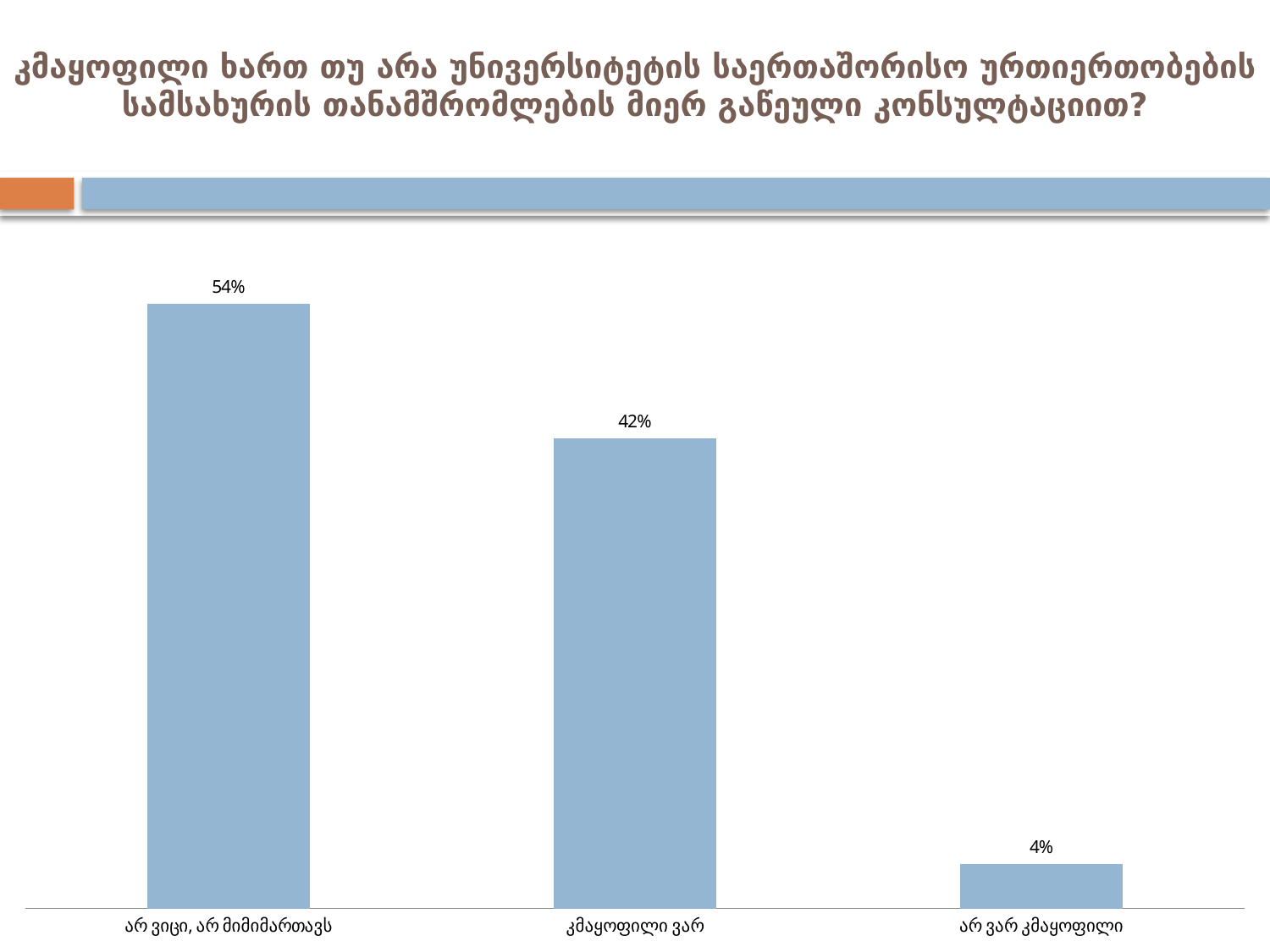
What kind of chart is shown on the slide? Bar chart What is the value for the category "არ ვიცი, არ მიმიმართავს"? 54% Which category has the highest value? არ ვიცი, არ მიმიმართავს Which category has the lowest value? არ ვარ კმაყოფილი What is the value for the category "არ ვარ კმაყოფილი"? 4% What colour are the bars in the chart? Light blue Do the values rise or fall from left to right across the categories? Fall What is the value for the category "კმაყოფილი ვარ"? 42% What is the difference between the values for "კმაყოფილი ვარ" and "არ ვარ კმაყოფილი"? 38% What is the difference between the values for "არ ვიცი, არ მიმიმართავს" and "კმაყოფილი ვარ"? 12% How many categories are shown in the chart? 3 Which is larger, the value for "კმაყოფილი ვარ" or the value for "არ ვარ კმაყოფილი"? კმაყოფილი ვარ